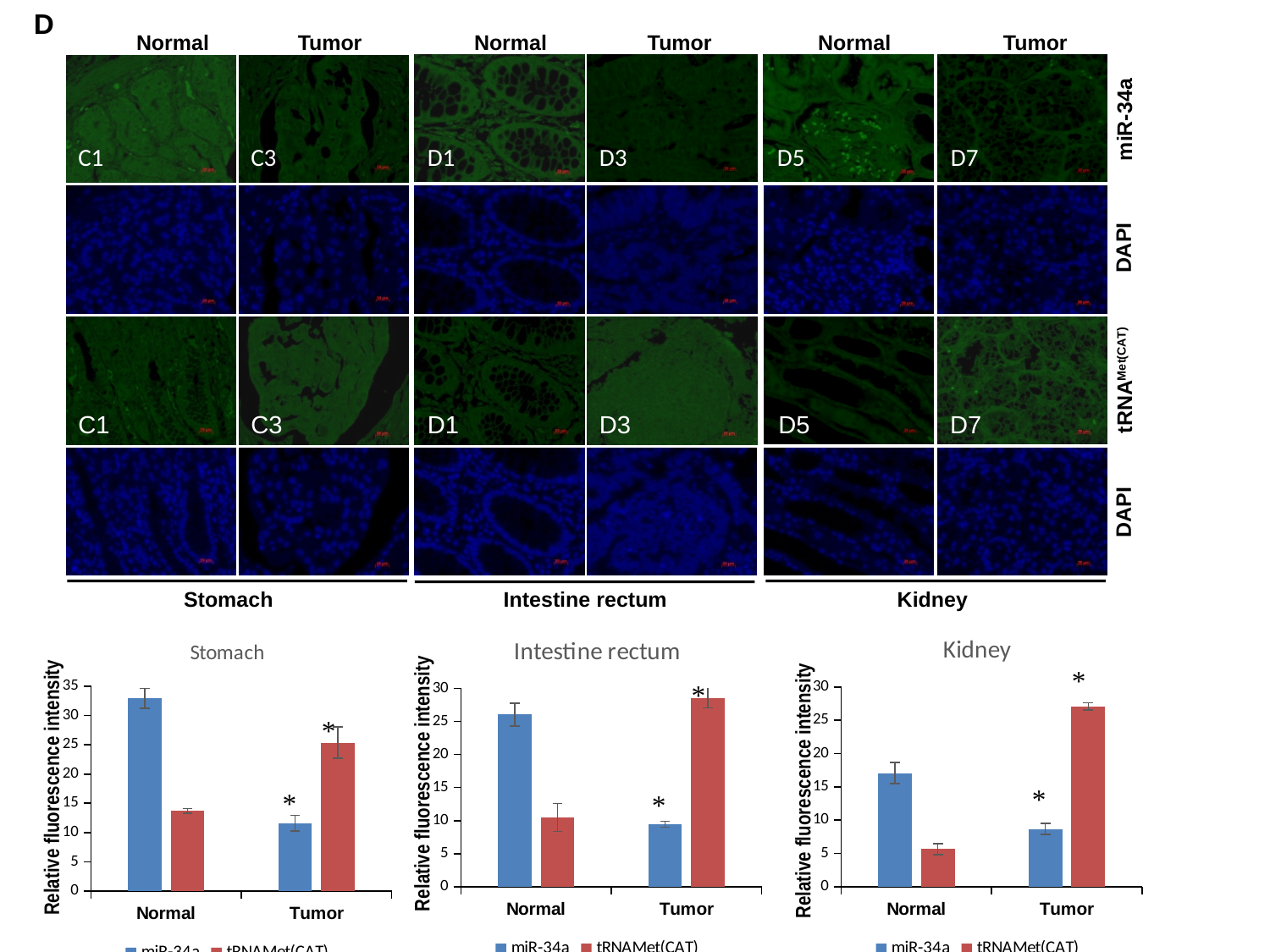
On the Stomach chart, how many series does the legend list? 2 On the Intestine rectum chart, which series has the higher value for Tumor? tRNAMet(CAT) On the Intestine rectum chart, how many categories are shown on the x axis? 2 On the Kidney chart, which category has the highest tRNAMet(CAT) value? Tumor On the Stomach chart, which is larger for miR-34a: Normal or Tumor? Normal On the Stomach chart, is the tRNAMet(CAT) value for Tumor greater or less than 20? greater On the Kidney chart, is the tRNAMet(CAT) value for Normal greater or less than 10? less On the Stomach chart, is the miR-34a value for Normal greater or less than 30? greater On the Stomach chart, what kind of chart is shown? bar chart On the Stomach chart, what is the title of the y axis? Relative fluorescence intensity